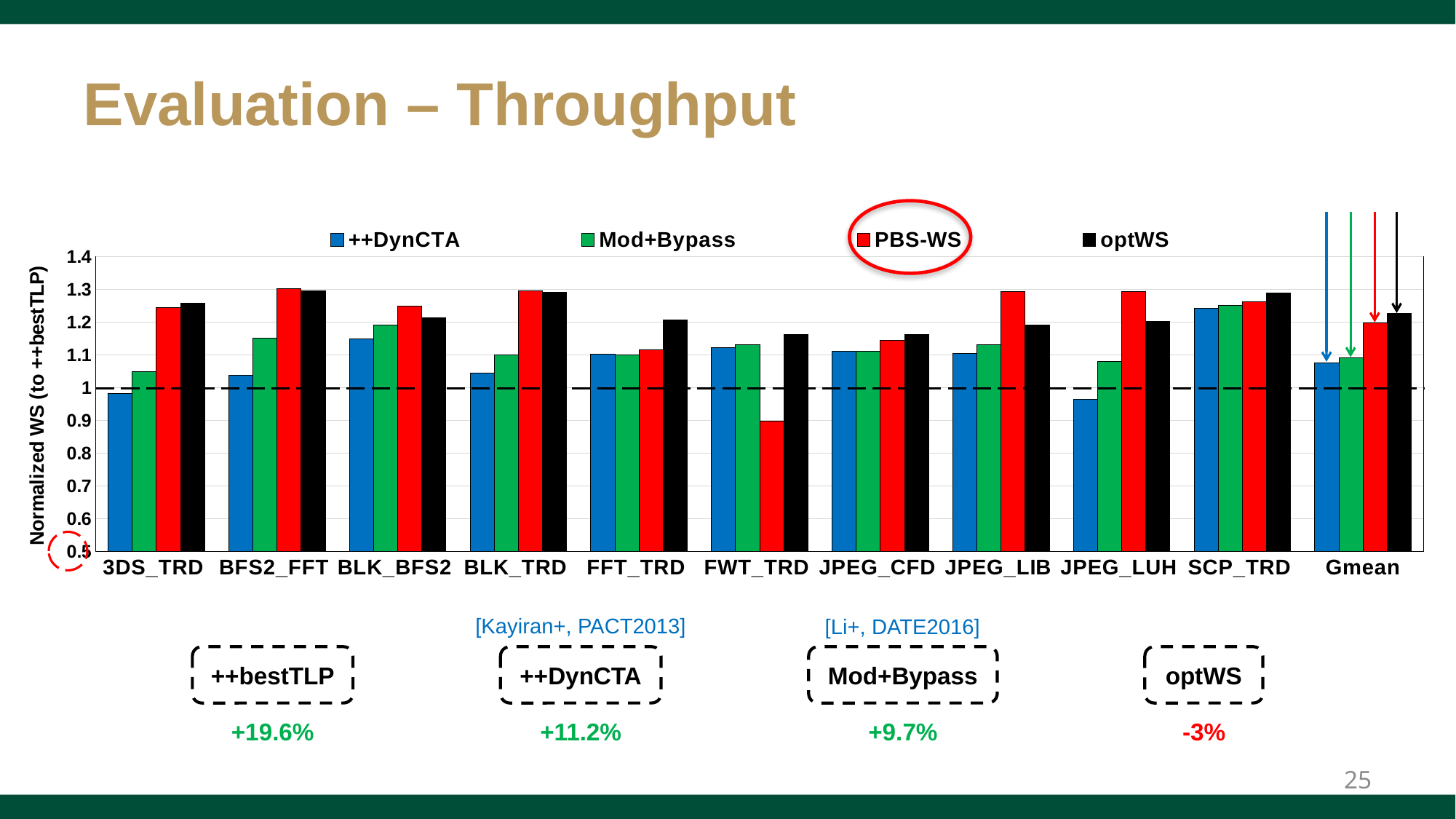
What is the title of the chart's y axis? Normalized WS (to ++bestTLP) For FWT_TRD, which series has the lowest value? PBS-WS For JPEG_LIB, which series has the highest value? PBS-WS What kind of chart is shown on the slide? bar chart Is the PBS-WS value for Gmean greater or less than 1.1? greater Is the PBS-WS value for FWT_TRD greater or less than 1? less For JPEG_LUH, which is larger: the PBS-WS value or the optWS value? PBS-WS Is the ++DynCTA value for 3DS_TRD greater or less than 1? less How many series does the chart's legend list? 4 For FWT_TRD, which is larger: the PBS-WS value or the optWS value? optWS How many categories are shown along the x axis of the chart? 11